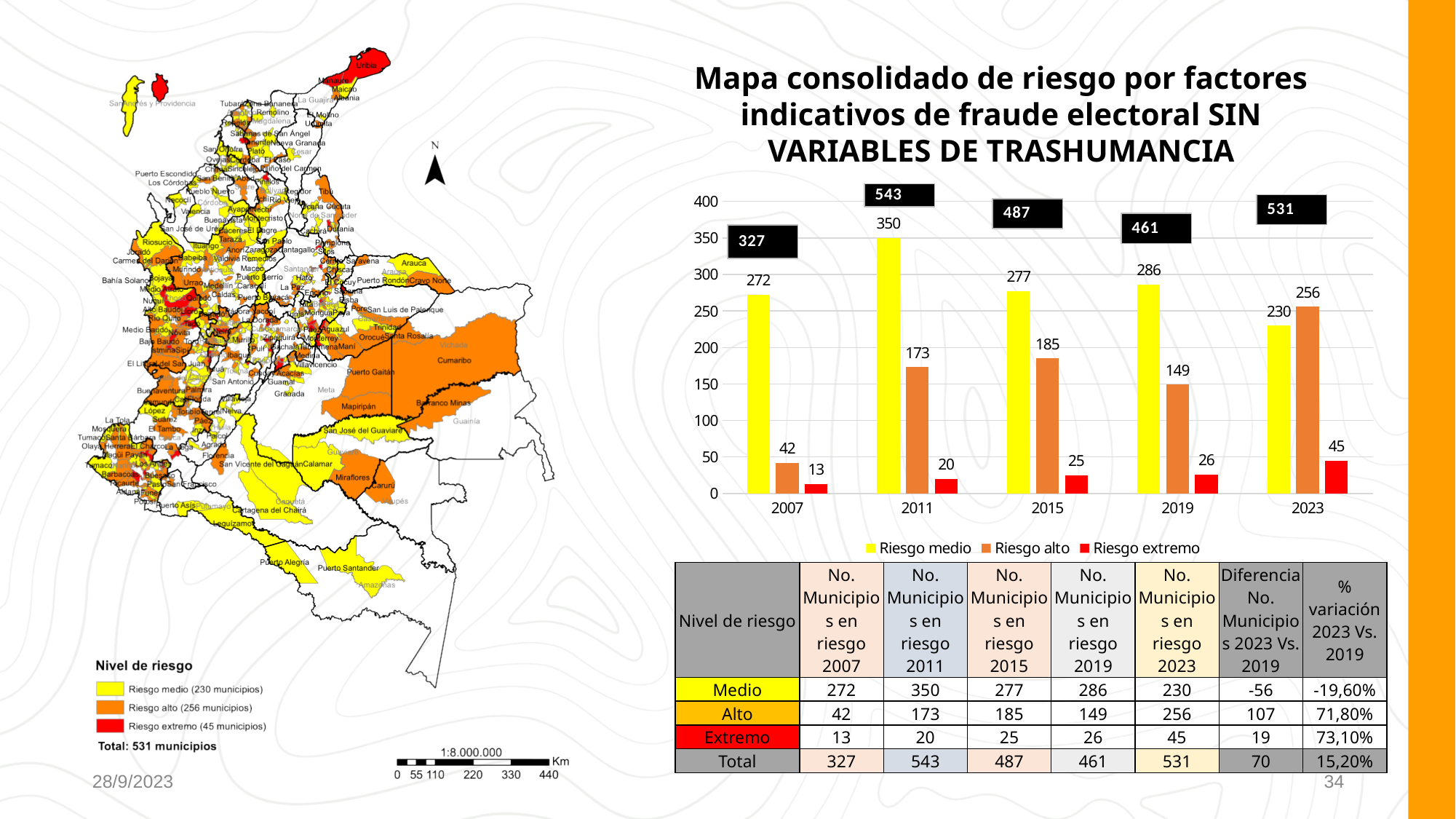
What is the value for Riesgo extremo in 2015? 25 How many years are shown on the x axis of the chart? 5 What is the total number of municipalities shown above the bars for 2015? 487 What is the difference between the Riesgo alto values in 2023 and 2019? 107 In which year is the Riesgo extremo value lowest? 2007 In which year is the Riesgo medio value highest? 2011 What is the value for Riesgo alto in 2023? 256 What is the value for Riesgo medio in 2011? 350 How many series does the chart legend list? 3 Does the Riesgo extremo value rise or fall from 2007 to 2023? rise Which is larger in 2023, Riesgo medio or Riesgo alto? Riesgo alto What kind of chart is shown on the slide? bar chart